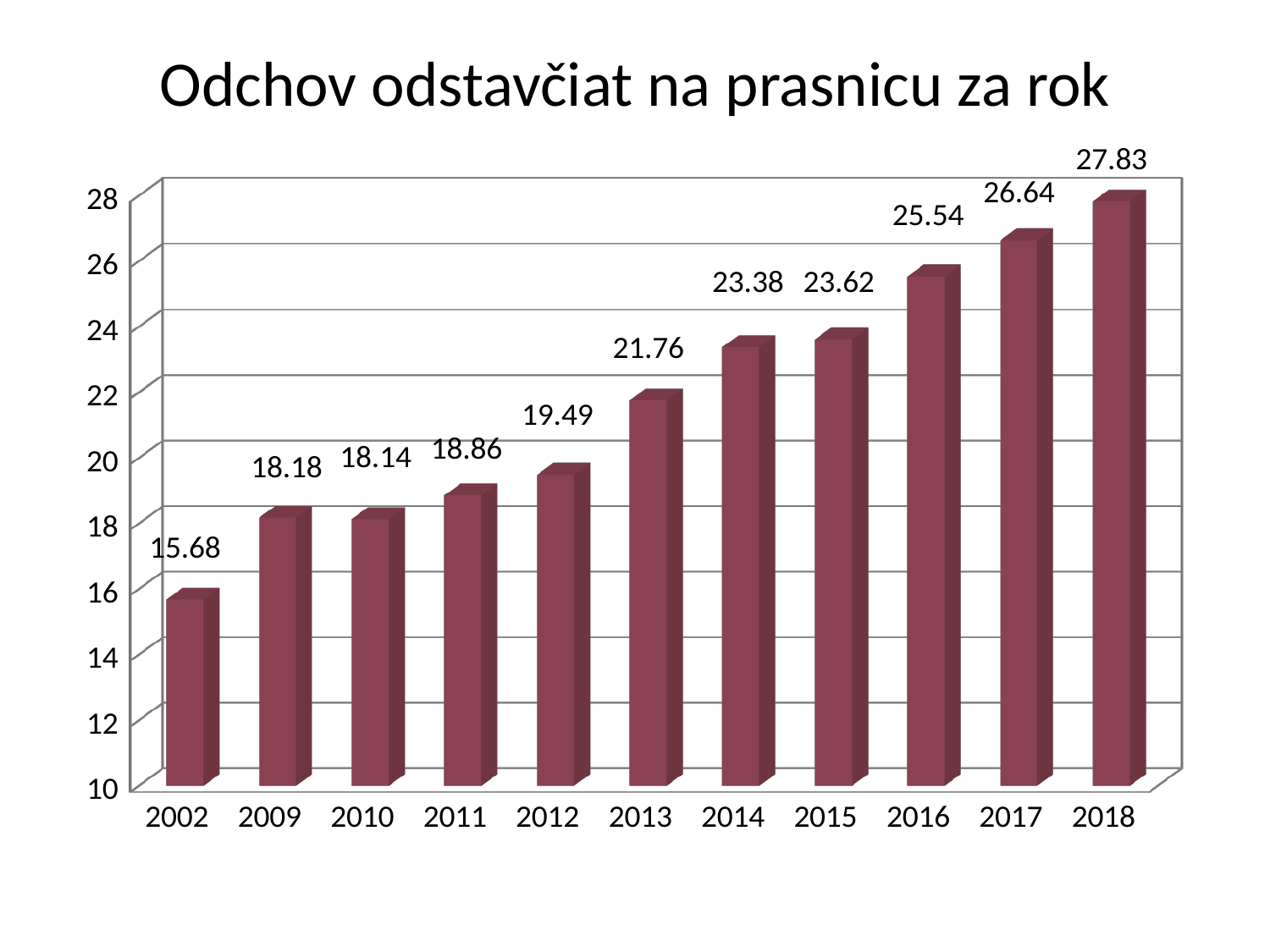
Which year has the highest value? 2018 What is the difference between the values for 2016 and 2015? 1.92 Which is larger, the value for 2009 or the value for 2010? 2009 Which year has the lowest value? 2002 What is the difference between the values for 2018 and 2002? 12.15 What is the value for 2013? 21.76 Is the value for 2014 greater or less than 22? greater What is the value for 2017? 26.64 What kind of chart is shown on the slide? bar chart What is the value for 2002? 15.68 How many years are shown on the x axis? 11 What is the title of the chart? Odchov odstavčiat na prasnicu za rok